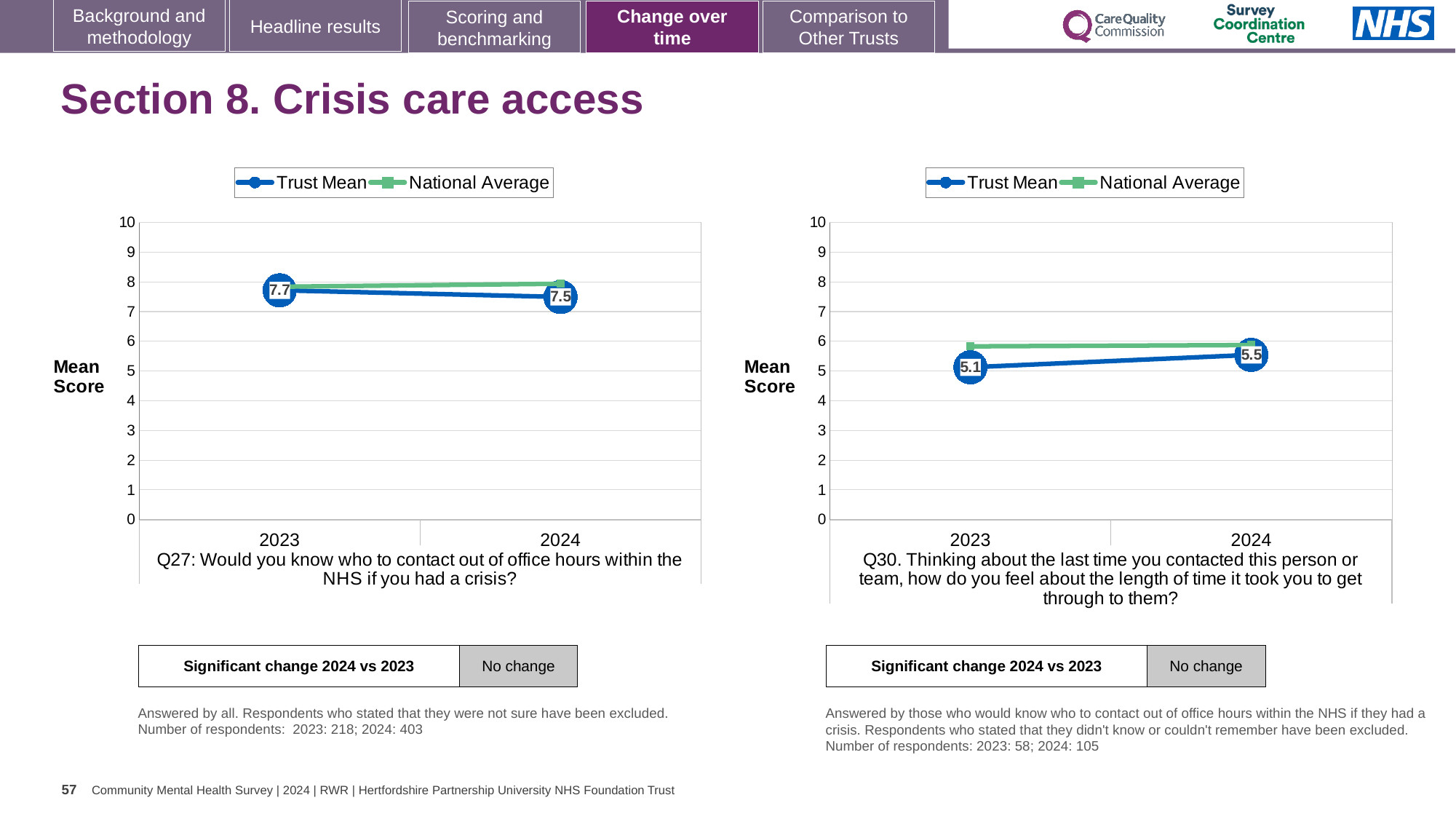
In the Q30 chart on the right, is the National Average for 2023 greater or less than 5? greater How many series does the legend of the Q27 chart on the left list? 2 In the Q27 chart on the left, what is the Trust Mean for 2024? 7.5 In the Q30 chart on the right, which is higher in 2023, the Trust Mean or the National Average? National Average In the Q27 chart on the left, does the Trust Mean rise or fall from 2023 to 2024? fall In the Q30 chart on the right, by how much did the Trust Mean change from 2023 to 2024? 0.4 In the Q30 chart on the right, what is the Trust Mean for 2023? 5.1 In the Q27 chart on the left, what is the Trust Mean for 2023? 7.7 In the Q27 chart on the left, by how much did the Trust Mean change from 2023 to 2024? 0.2 What kind of chart is the Q30 chart on the right? line chart In the Q30 chart on the right, does the Trust Mean rise or fall from 2023 to 2024? rise In the Q30 chart on the right, what is the Trust Mean for 2024? 5.5